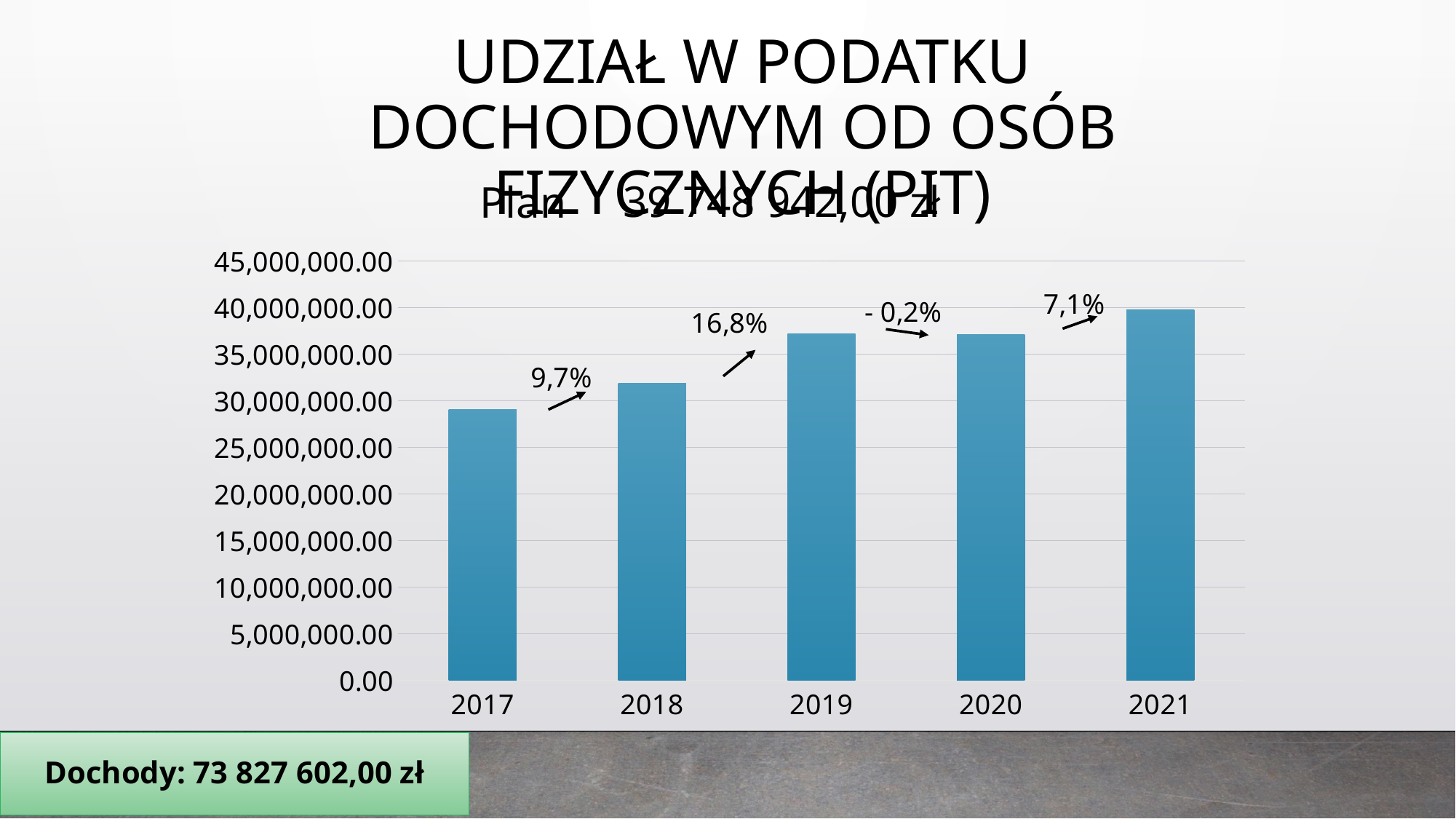
Is the value for 2018 greater or less than 30,000,000.00? greater What percentage change is annotated between the 2019 and 2020 bars? - 0,2% Which is larger, the value for 2017 or the value for 2018? 2018 What percentage change is annotated between the 2018 and 2019 bars? 16,8% What kind of chart is shown on the slide? bar chart Which year has the highest bar in the chart? 2021 Is the value for 2021 greater or less than 35,000,000.00? greater What percentage change is annotated between the 2020 and 2021 bars? 7,1% Is the value for 2019 greater or less than 35,000,000.00? greater Which year has the lowest bar in the chart? 2017 How many years are shown on the x axis of the chart? 5